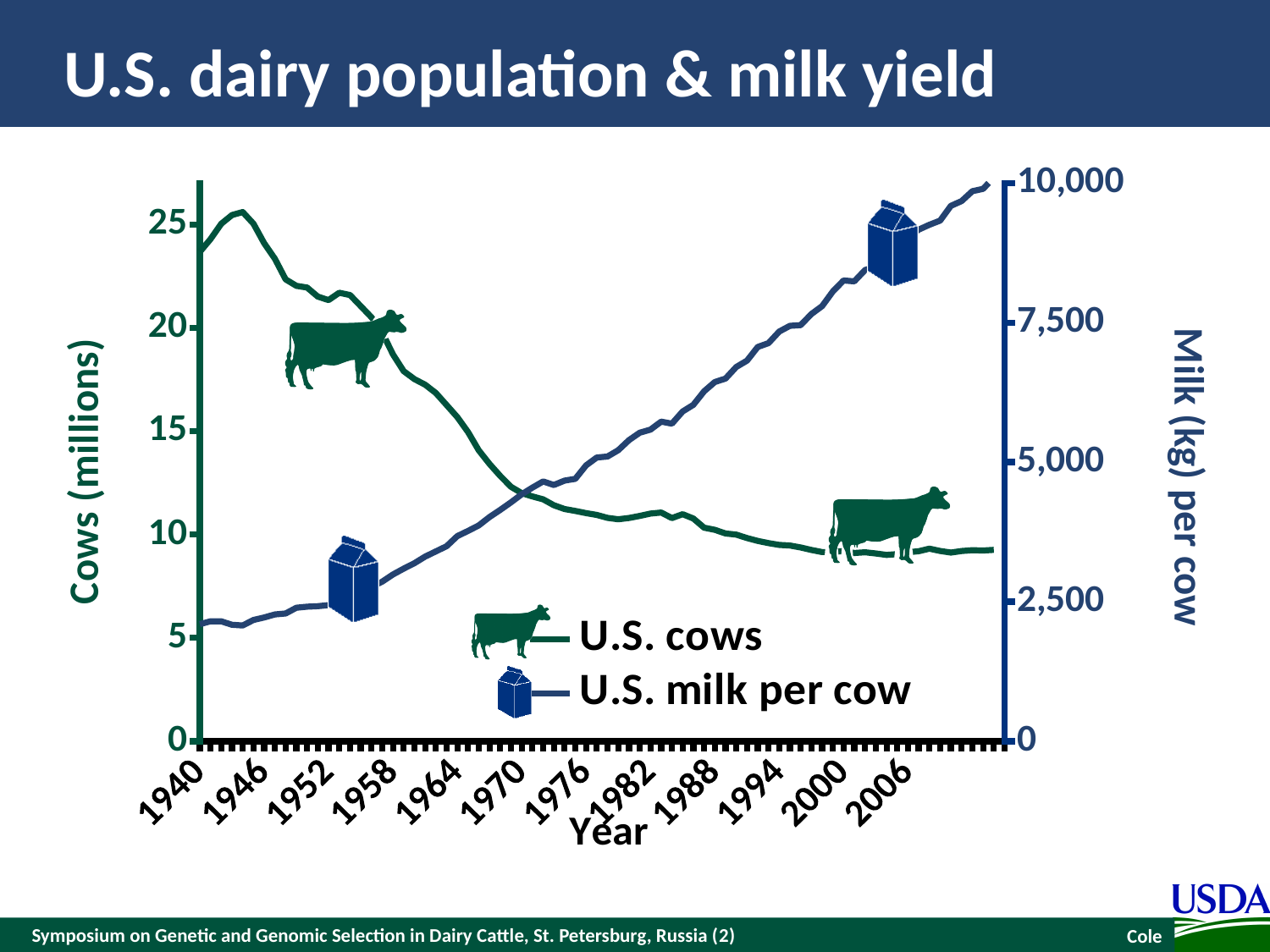
Is the value for U.S. milk per cow in 1940 greater or less than 2,500 kg? less What is the title of the chart on the slide? U.S. dairy population & milk yield Is the value for U.S. cows in 2006 greater or less than 10 million? less Is the value for U.S. milk per cow in 2006 greater or less than 7,500 kg? greater How many series does the legend list? 2 What kind of chart is shown on the slide? line chart What are the two series named in the legend? U.S. cows and U.S. milk per cow How many year labels are shown on the x axis? 12 Does the U.S. milk per cow series rise or fall from 1940 to 2006? rise Does the U.S. cows series rise or fall from 1940 to 2006? fall